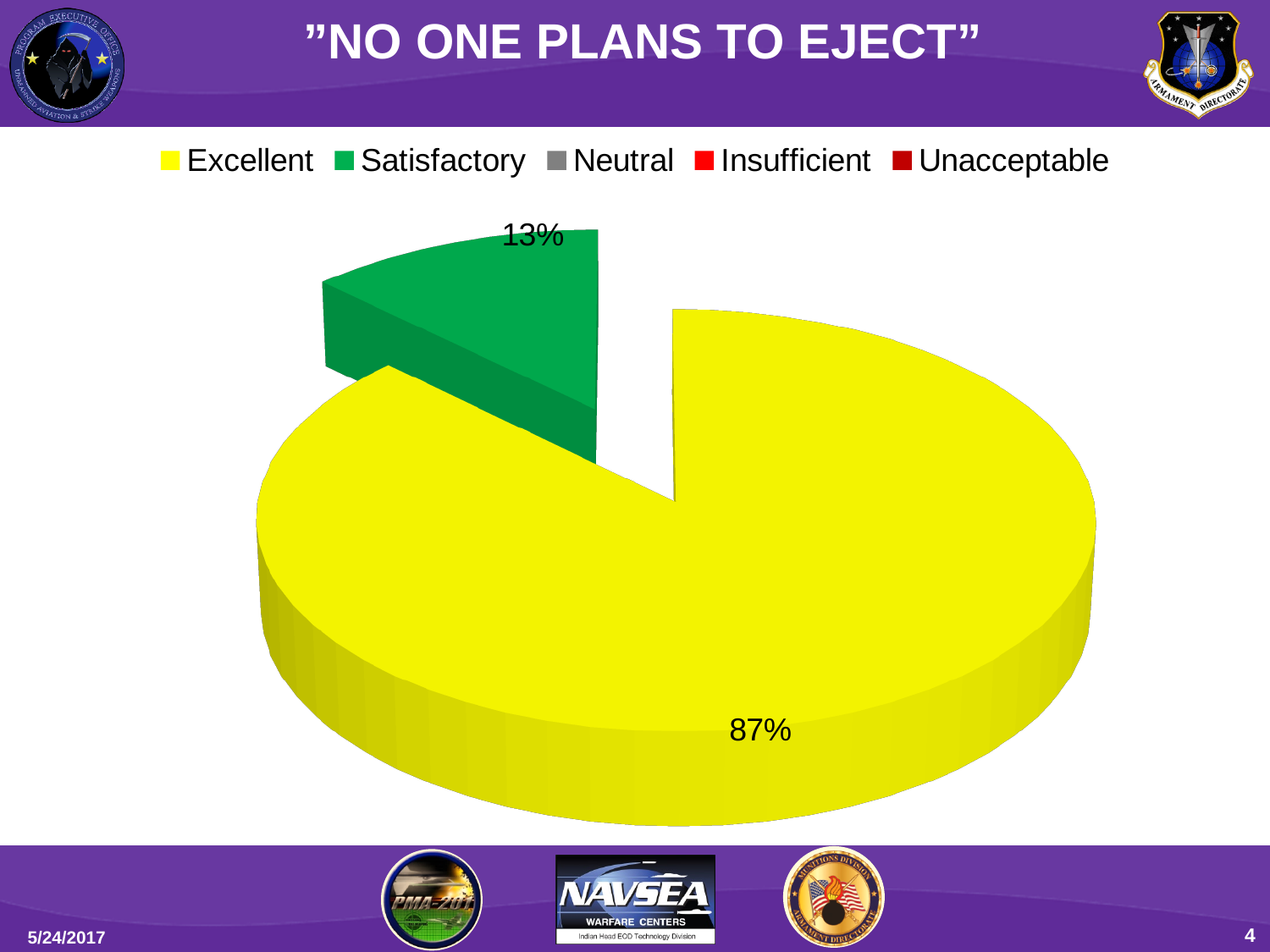
What share of the pie does the Satisfactory slice represent? 13% What kind of chart is shown on the slide? Pie chart Which is larger, the Excellent slice or the Satisfactory slice? Excellent How many slices are visible in the pie? 2 What is the title of the slide containing the pie chart? "NO ONE PLANS TO EJECT" How many categories does the legend list? 5 What is the difference between the Excellent share and the Satisfactory share? 74 percentage points Which category has the largest slice of the pie? Excellent What percentage of the pie is labelled for the Satisfactory slice? 13% What percentage of the pie is labelled for the Excellent slice? 87% What colour is used for the Excellent category in the pie? Yellow Of the two slices shown in the pie, which is the smaller one? Satisfactory